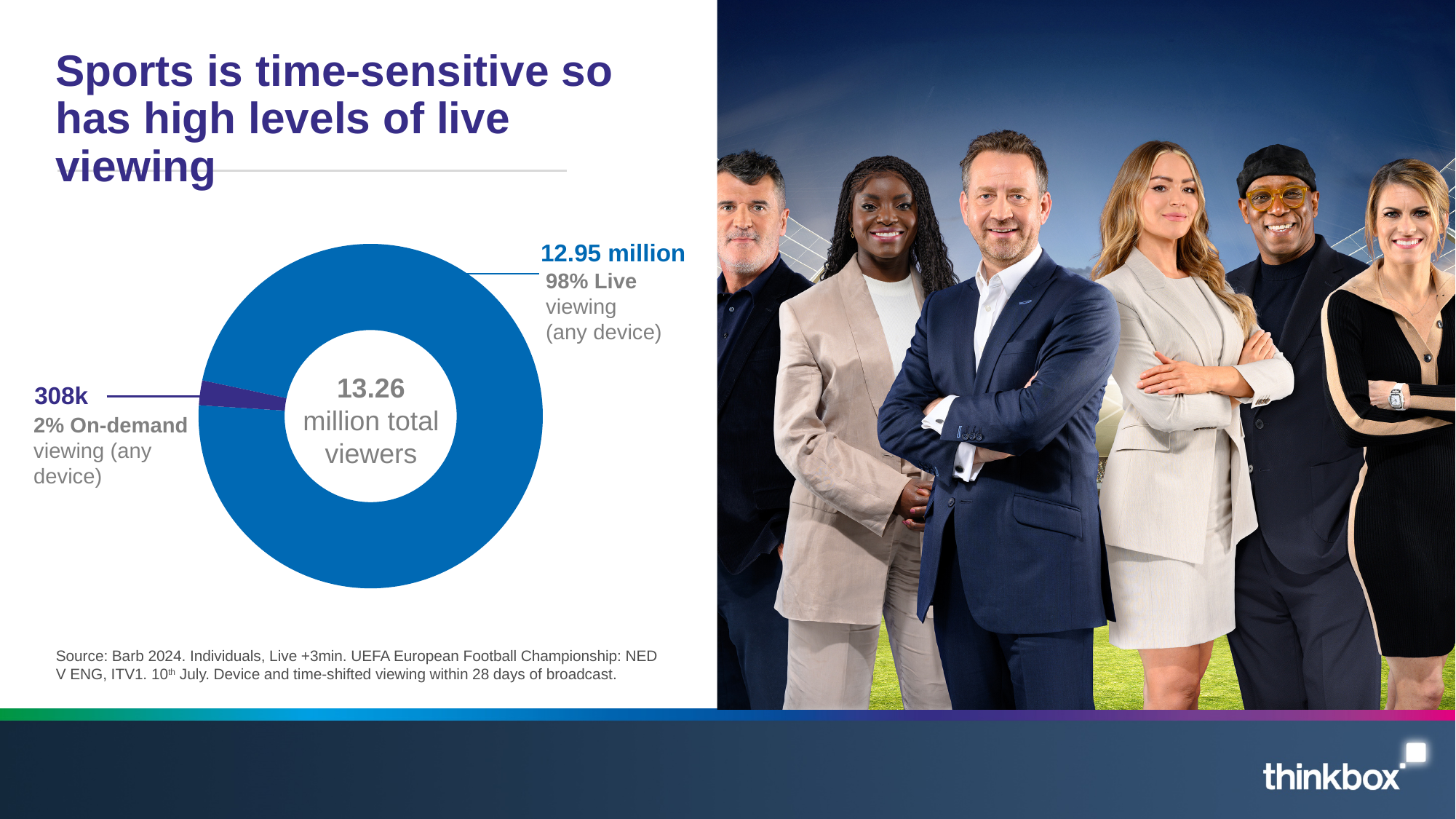
What is the value for Live viewing (any device)? 12.95 million What is the value for On-demand viewing (any device)? 308k What kind of chart is shown on the slide? Donut (pie) chart What is the total number of viewers shown in the centre of the donut chart? 13.26 million What share of total viewers is Live viewing? 98% What colour is the Live viewing segment of the donut chart? Blue What share of total viewers is On-demand viewing? 2% How many segments does the donut chart have? 2 Which is larger, Live viewing or On-demand viewing? Live viewing What colour is the On-demand viewing segment of the donut chart? Purple Which segment is the largest in the donut chart? Live viewing (any device) Which segment is the smallest in the donut chart? On-demand viewing (any device)